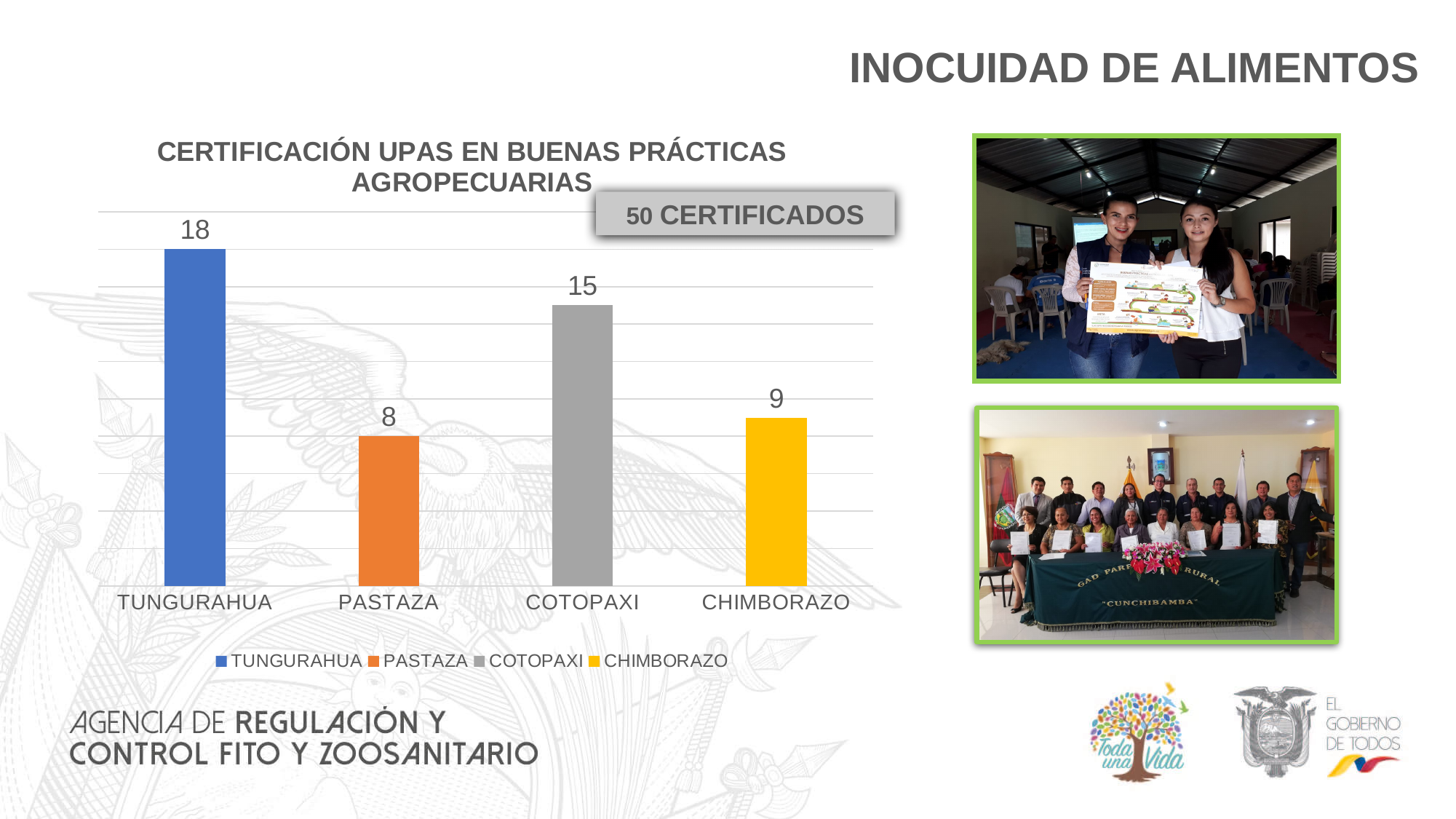
What kind of chart is shown on the slide? Bar chart How many categories are shown in the chart? 4 What is the value for CHIMBORAZO? 9 What is the value for COTOPAXI? 15 What is the difference between the values for TUNGURAHUA and COTOPAXI? 3 What is the value for TUNGURAHUA? 18 Which category has the lowest value? PASTAZA What is the title of the chart? CERTIFICACIÓN UPAS EN BUENAS PRÁCTICAS AGROPECUARIAS Which is larger, the value for CHIMBORAZO or the value for PASTAZA? CHIMBORAZO What is the total number of certificates stated in the box next to the chart? 50 CERTIFICADOS What is the value for PASTAZA? 8 Which category has the highest value? TUNGURAHUA